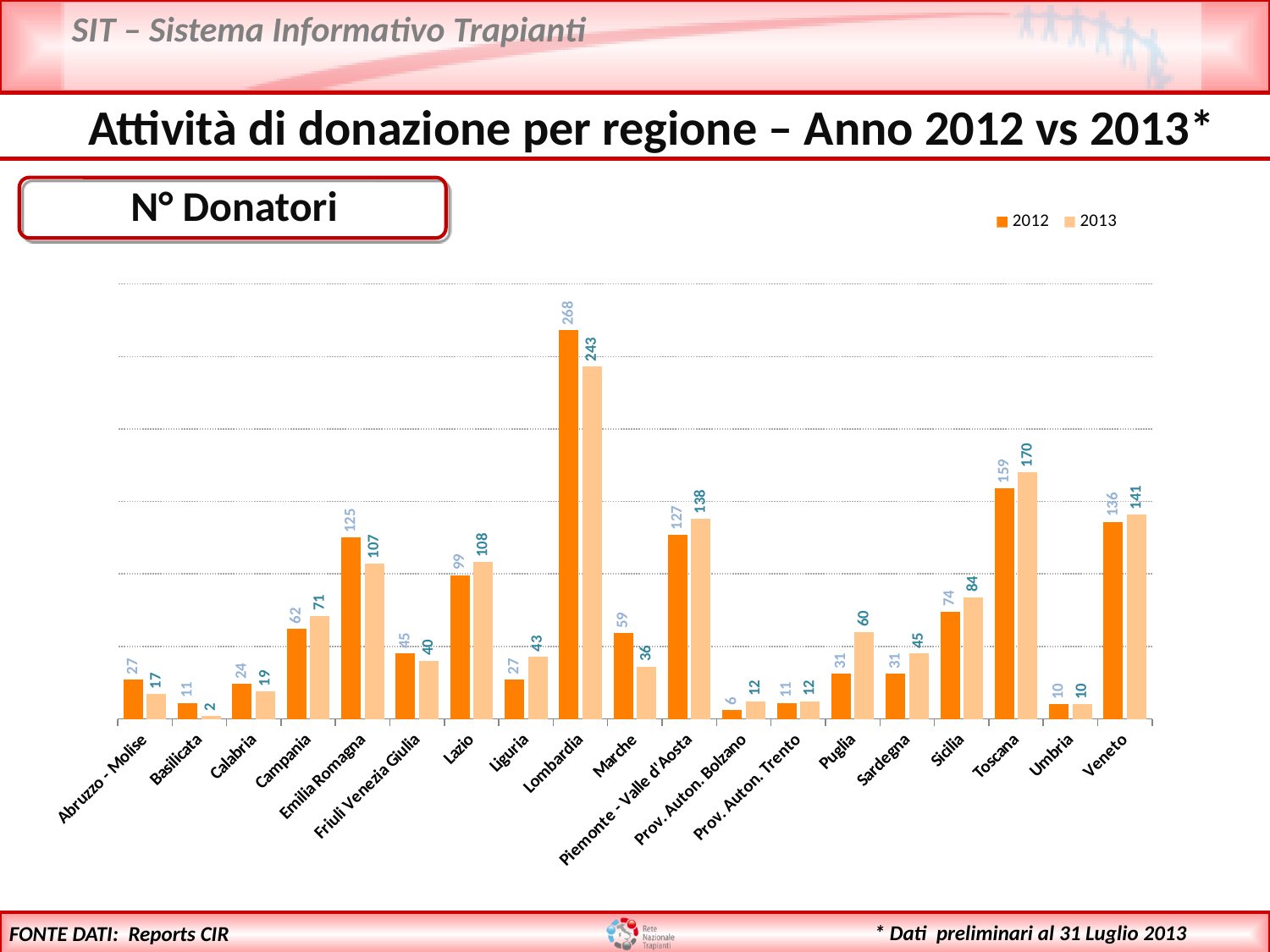
How many regions are shown on the x axis of the chart? 19 What is the title shown in the box above the chart? N° Donatori What is the difference between the 2013 and 2012 donor counts for Puglia? 29 Which region has the lowest number of donors in 2012? Prov. Auton. Bolzano What is the number of donors for Puglia in 2013? 60 What is the number of donors for Lombardia in 2012? 268 Which is larger for Lazio: the 2012 value or the 2013 value? 2013 What is the number of donors for Toscana in 2013? 170 What is the difference between the 2012 and 2013 donor counts for Emilia Romagna? 18 What kind of chart is shown on the slide? Bar chart How many series does the legend list? 2 Which region has the highest number of donors in 2013? Lombardia